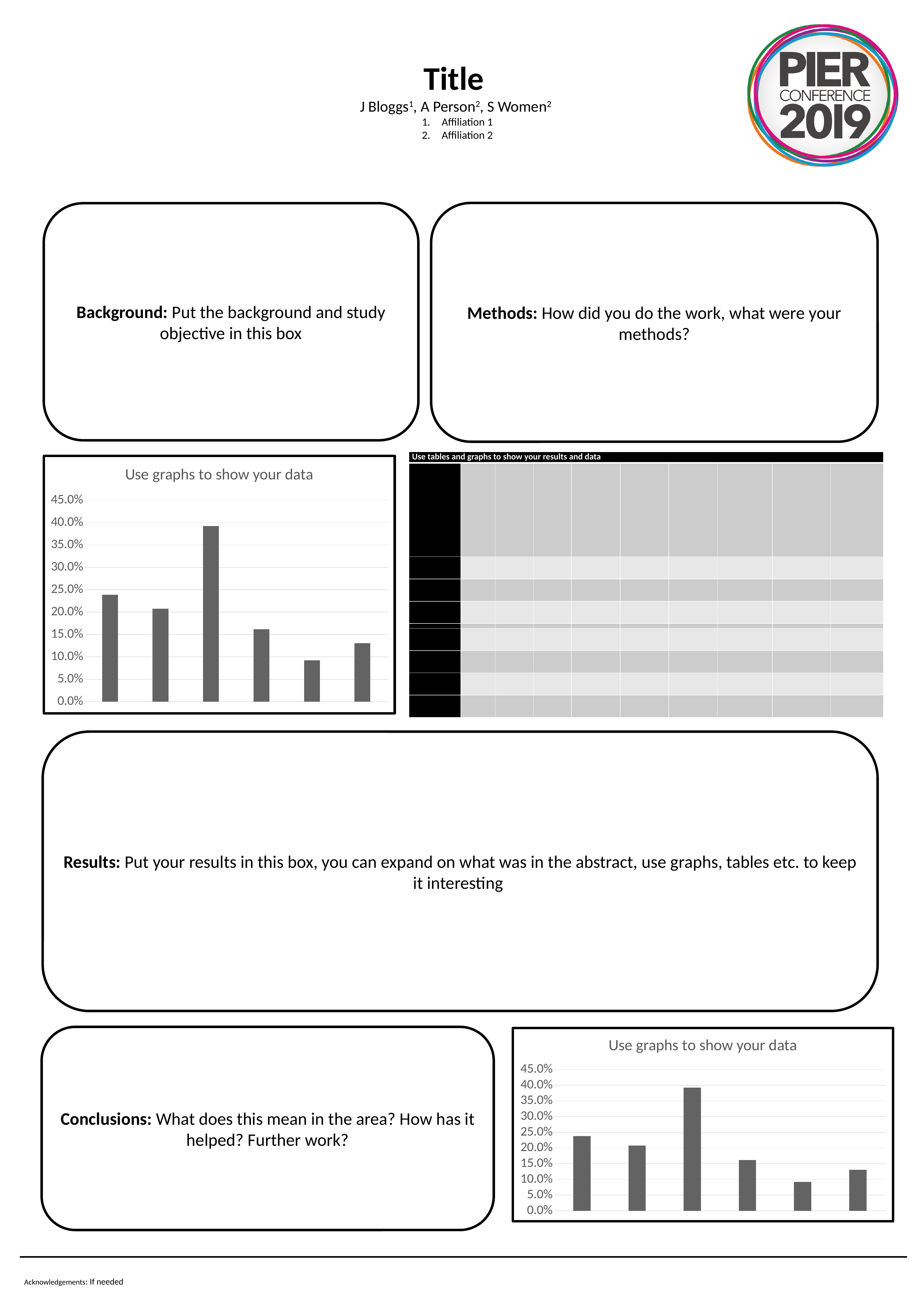
What is the title of the chart on the middle-left of the slide? Use graphs to show your data In the chart on the middle-left of the slide, which bar is the shortest, counting from the left? the fifth bar How many bars does the chart at the bottom-right of the slide have? 6 In the chart at the bottom-right of the slide, which is larger: the fourth bar or the sixth bar from the left? the fourth bar In the chart at the bottom-right of the slide, is the value of the first bar from the left greater or less than 20.0%? greater What kind of chart is the chart on the middle-left of the slide? bar chart How many bars does the chart on the middle-left of the slide have? 6 In the chart on the middle-left of the slide, is the value of the third bar from the left greater or less than 35.0%? greater What kind of chart is the chart at the bottom-right of the slide? bar chart In the chart on the middle-left of the slide, which bar is the tallest, counting from the left? the third bar In the chart on the middle-left of the slide, which is larger: the first bar or the second bar from the left? the first bar